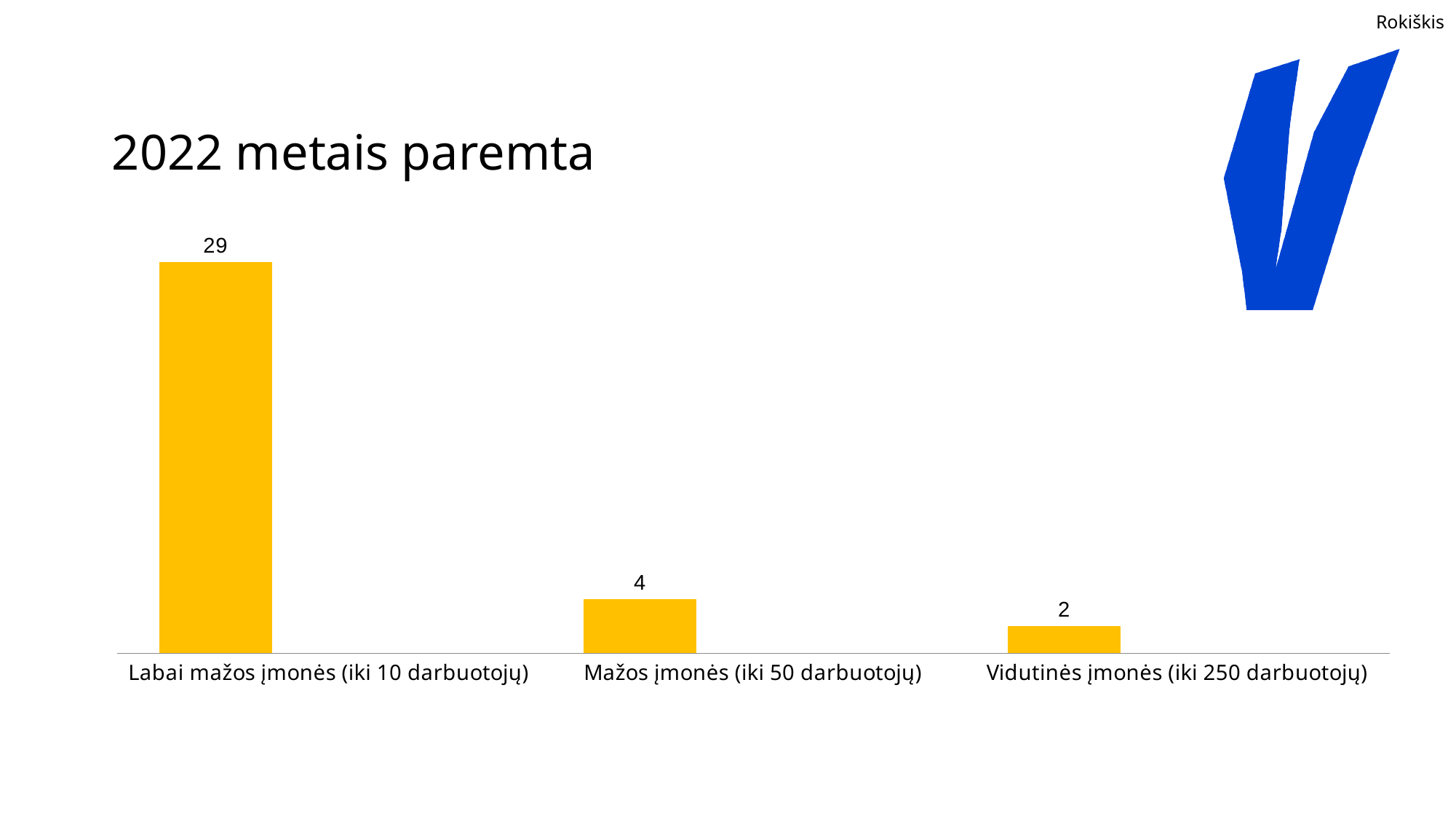
Which category has the lowest value? Vidutinės įmonės (iki 250 darbuotojų) Do the values rise or fall from left to right along the x axis? Fall Which category has the highest value? Labai mažos įmonės (iki 10 darbuotojų) What is the difference between the values for Labai mažos įmonės (iki 10 darbuotojų) and Mažos įmonės (iki 50 darbuotojų)? 25 How many categories are shown in the chart? 3 What kind of chart is shown on the slide? Bar chart Which is larger: the value for Mažos įmonės (iki 50 darbuotojų) or Vidutinės įmonės (iki 250 darbuotojų)? Mažos įmonės (iki 50 darbuotojų) What is the value for Vidutinės įmonės (iki 250 darbuotojų)? 2 What is the title of the slide? 2022 metais paremta What is the value for Labai mažos įmonės (iki 10 darbuotojų)? 29 What is the difference between the values for Mažos įmonės (iki 50 darbuotojų) and Vidutinės įmonės (iki 250 darbuotojų)? 2 What is the value for Mažos įmonės (iki 50 darbuotojų)? 4